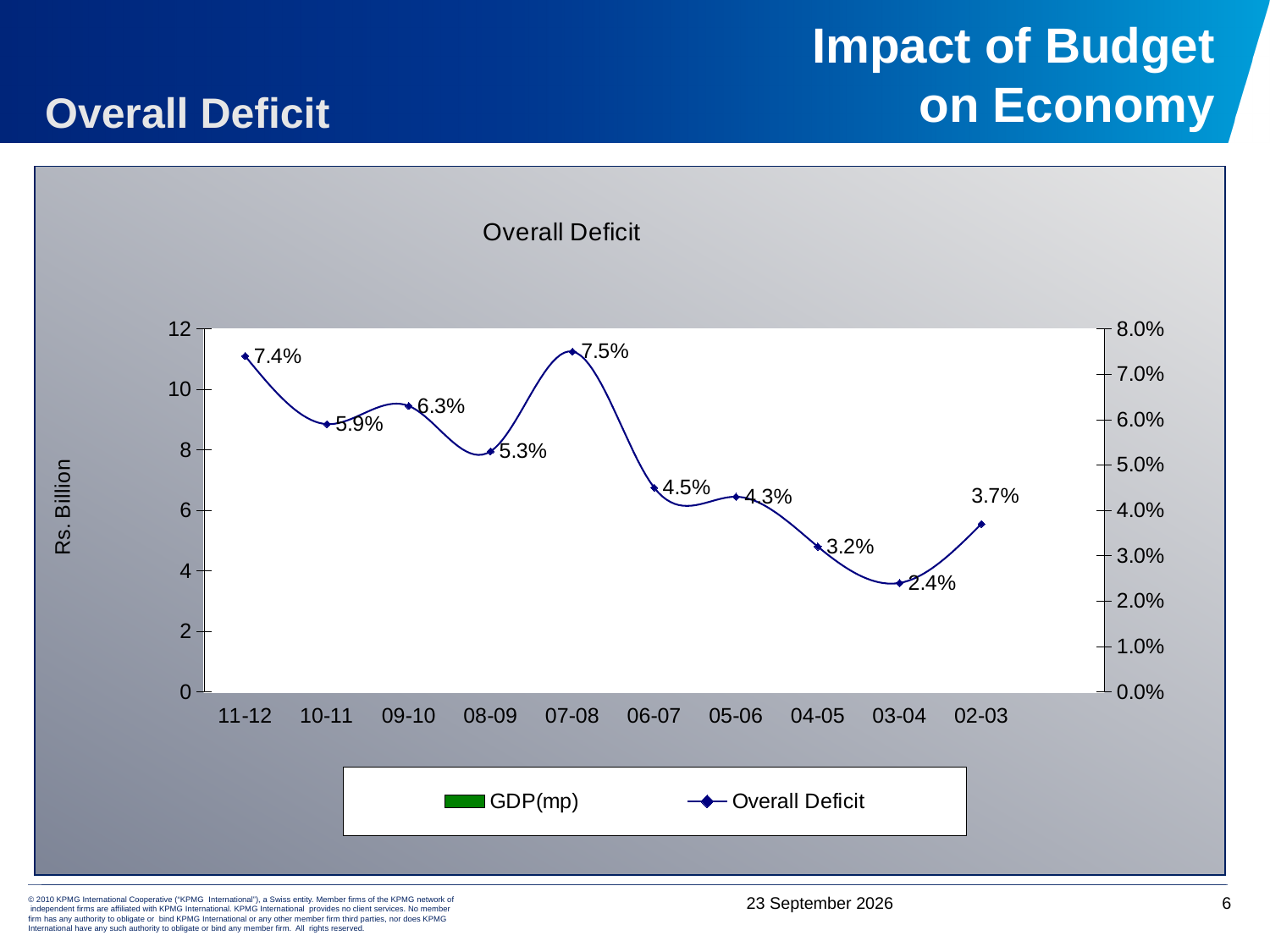
Which year has the lowest Overall Deficit percentage? 03-04 How many years are shown on the x axis? 10 What kind of chart is shown on the slide? Line chart Which year has the highest Overall Deficit percentage? 07-08 What is the Overall Deficit value for 07-08? 7.5% How many series does the legend list? 2 Which is larger, the Overall Deficit for 06-07 or for 05-06? 06-07 What is the Overall Deficit value for 02-03? 3.7% What is the label of the left vertical axis? Rs. Billion What is the Overall Deficit value for 03-04? 2.4% What is the difference between the Overall Deficit values for 10-11 and 09-10? 0.4% What is the Overall Deficit value for 11-12? 7.4%